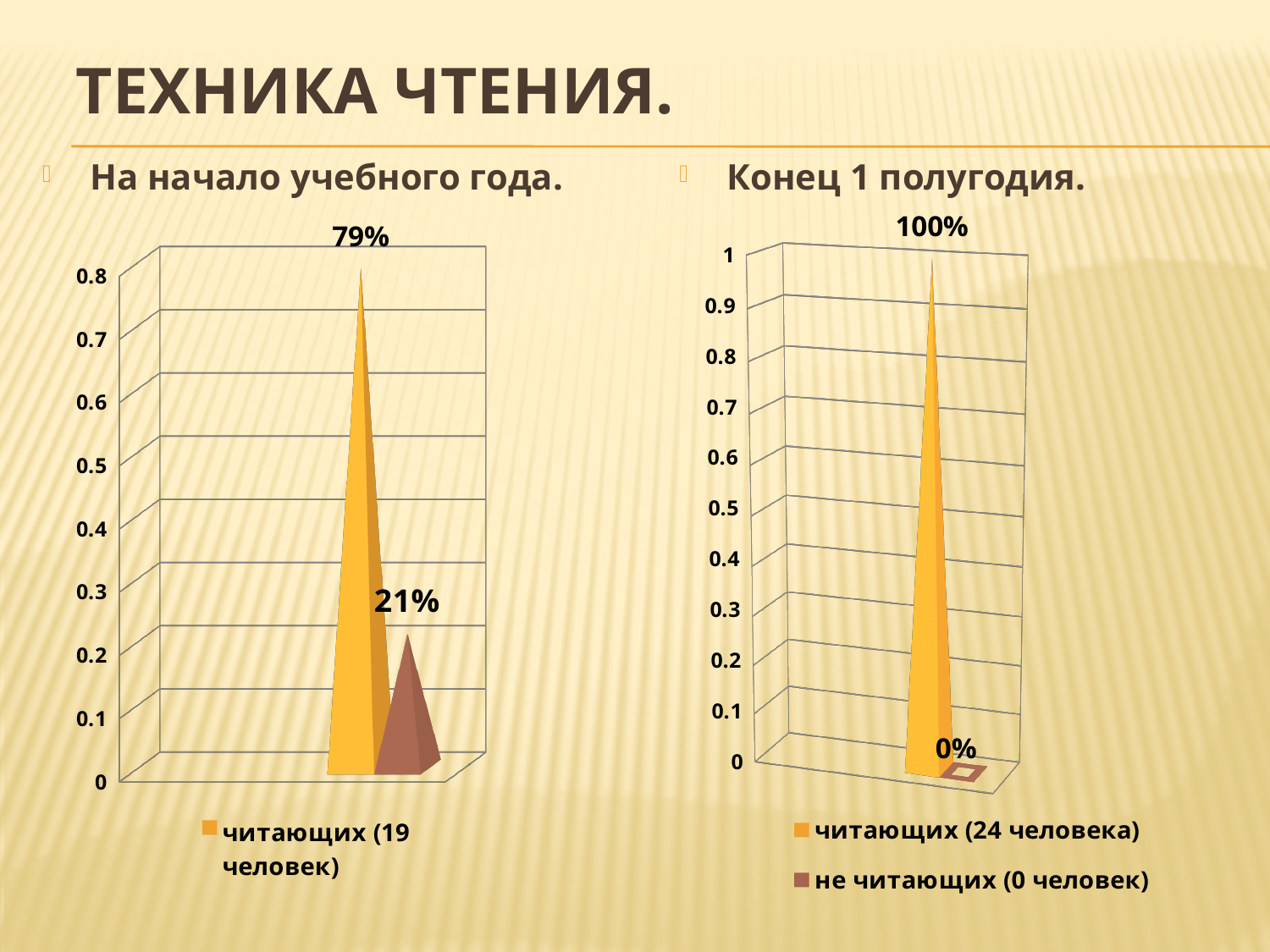
On the right chart (Конец 1 полугодия), what value is shown for не читающих (0 человек)? 0% On the right chart (Конец 1 полугодия), what value is shown for читающих (24 человека)? 100% On the left chart (На начало учебного года), what value is shown for читающих (19 человек)? 79% On the right chart (Конец 1 полугодия), which series has the lowest value? не читающих (0 человек) How many series does the legend of the right chart (Конец 1 полугодия) list? 2 What kind of chart is the left chart (На начало учебного года)? bar chart On the left chart (На начало учебного года), which is larger: the value for читающих (19 человек) or the brown bar's value? читающих (19 человек) On the right chart (Конец 1 полугодия), which series has the highest value? читающих (24 человека) On the left chart (На начало учебного года), what is the value of the smaller, brown bar? 21% On the right chart (Конец 1 полугодия), what is the difference between the values for читающих and не читающих? 100% What is the title of the slide? ТЕХНИКА ЧТЕНИЯ. On the left chart (На начало учебного года), what is the difference between the two plotted values, 79% and 21%? 58%